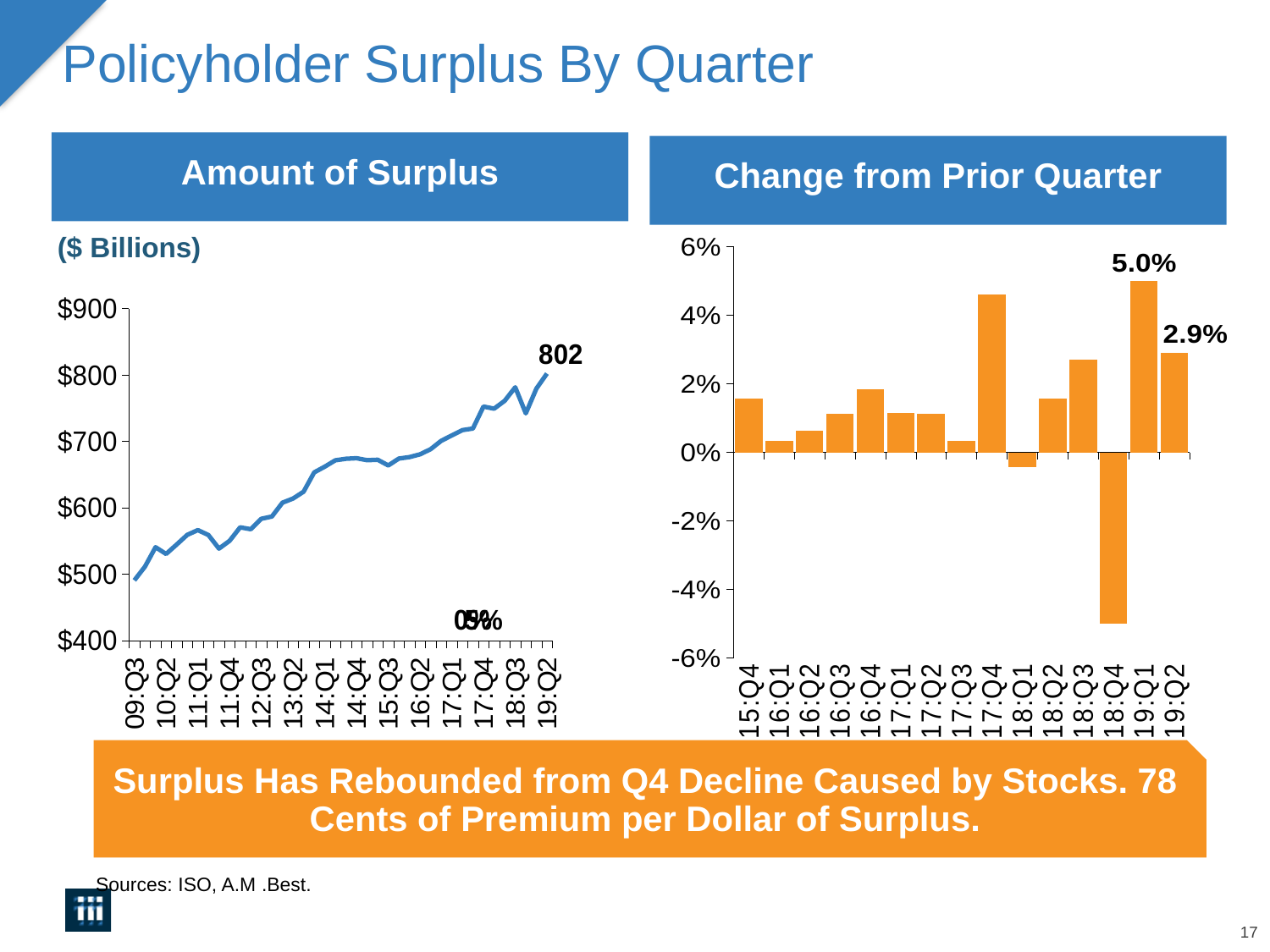
On the Change from Prior Quarter chart, what is the value for 19:Q1? 5.0% On the Change from Prior Quarter chart, what is the value for 19:Q2? 2.9% On the Change from Prior Quarter chart, which quarter has the lowest value? 18:Q4 On the Amount of Surplus chart, what is the value labeled for 19:Q2? 802 What kind of chart is the Amount of Surplus chart? line chart On the Change from Prior Quarter chart, which quarter has the highest value? 19:Q1 On the Change from Prior Quarter chart, is the value for 18:Q4 greater or less than -4%? less On the Amount of Surplus chart, do values generally rise or fall from 09:Q3 to 19:Q2? rise How many quarters are shown on the Change from Prior Quarter chart? 15 On the Change from Prior Quarter chart, which is larger, the value for 17:Q4 or the value for 18:Q3? 17:Q4 What kind of chart is the Change from Prior Quarter chart? bar chart On the Change from Prior Quarter chart, what is the difference between the values for 19:Q1 and 19:Q2? 2.1 percentage points